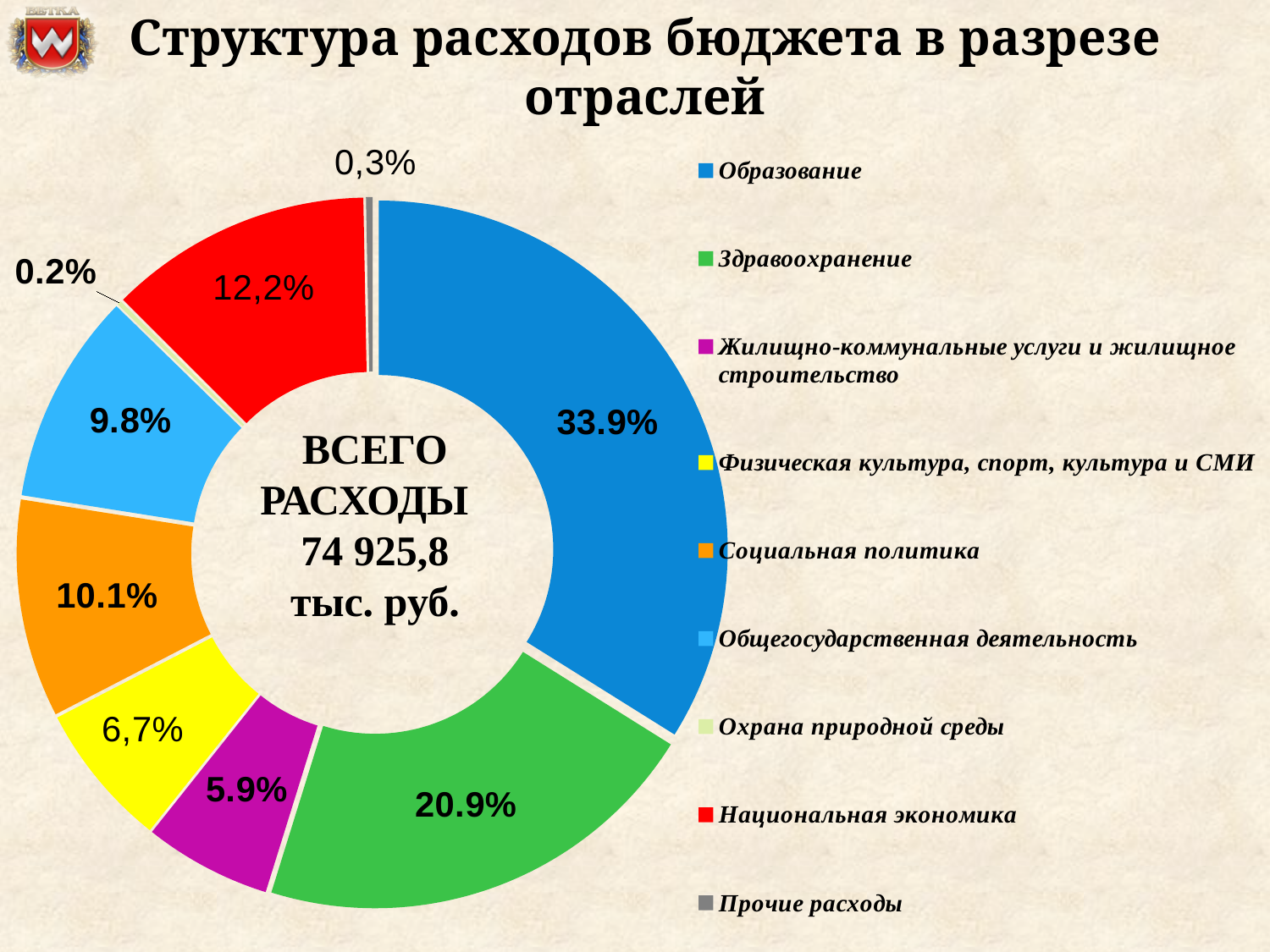
What share of budget expenditures goes to Физическая культура, спорт, культура и СМИ? 6,7% What share of budget expenditures goes to Национальная экономика? 12,2% How many sectors are listed in the chart legend? 9 What is the difference in percentage points between the shares for Образование and Здравоохранение? 13 percentage points Which sector has the largest share of budget expenditures? Образование What type of chart is shown on the slide? Doughnut (pie) chart What share of budget expenditures goes to Социальная политика? 10.1% Which sector has the smallest share of budget expenditures? Охрана природной среды Which has a larger share: Социальная политика or Общегосударственная деятельность? Социальная политика What share of budget expenditures goes to Образование (education)? 33.9% What total expenditure amount is shown in the centre of the chart? 74 925,8 тыс. руб. What share of budget expenditures goes to Здравоохранение (healthcare)? 20.9%